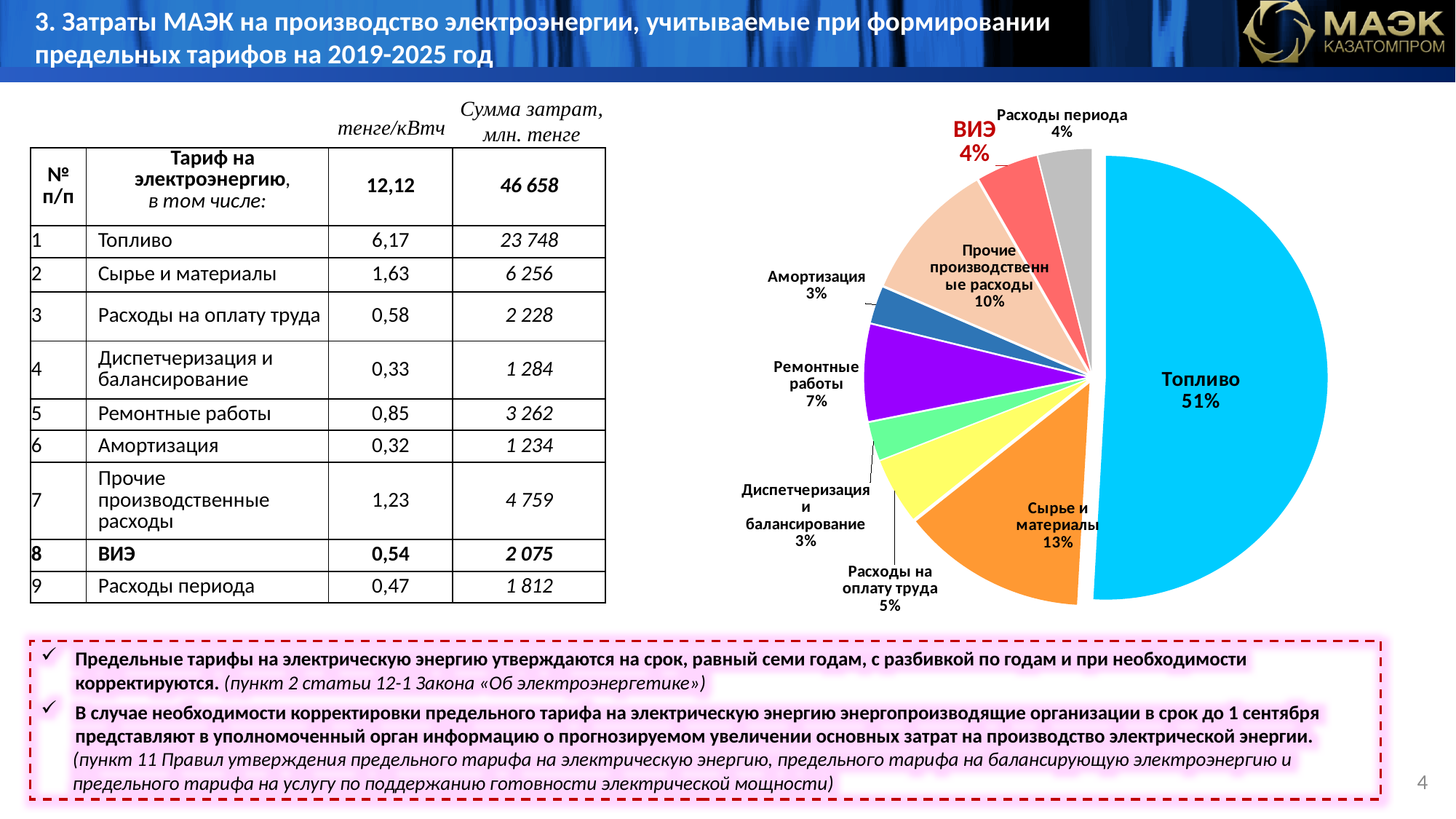
What share of the pie does Ремонтные работы have? 7% What share of the pie does Сырье и материалы have? 13% What share of the pie does Топливо have? 51% What is the combined share of the Амортизация and Диспетчеризация и балансирование slices? 6% Which slice of the pie chart is the largest? Топливо How many slices does the pie chart have? 9 Which slice label in the pie chart is printed in red? ВИЭ What kind of chart is shown on the slide? pie chart Which is larger in the pie chart, Ремонтные работы or Расходы на оплату труда? Ремонтные работы What is the difference in percentage points between the Топливо slice and the Сырье и материалы slice? 38